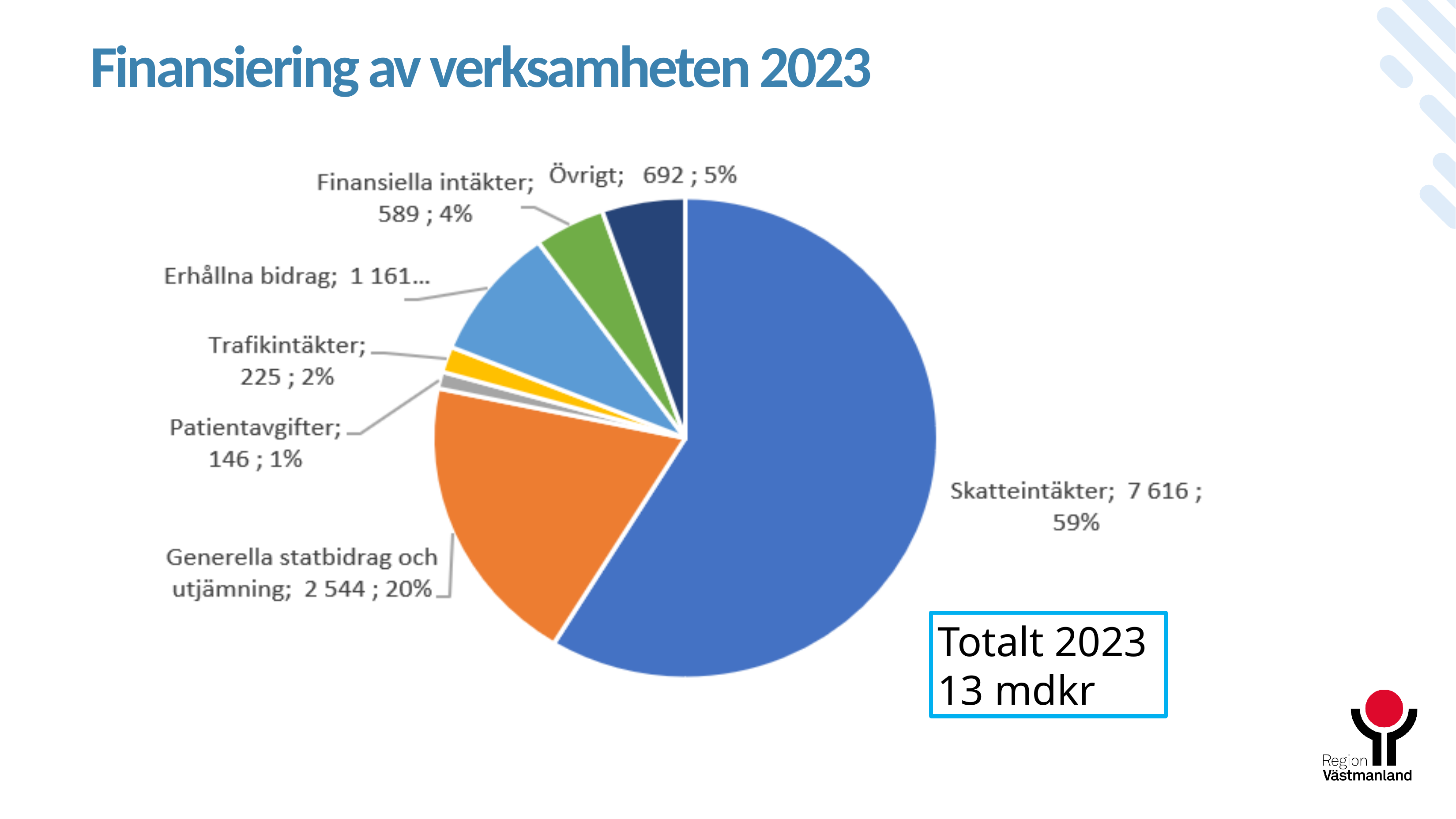
What is the value for Skatteintäkter? 7 616 What is the value for Generella statbidrag och utjämning? 2 544 What is the value for Patientavgifter? 146 Which category has the largest slice of the pie? Skatteintäkter What is the value for Erhållna bidrag? 1 161 How many slices does the pie chart have? 7 What kind of chart is shown on the slide? pie chart What share of the pie does Generella statbidrag och utjämning represent? 20% Which is larger, the value for Övrigt or the value for Finansiella intäkter? Övrigt What share of the pie does Övrigt represent? 5% Which category has the smallest slice of the pie? Patientavgifter What is the difference between the values for Skatteintäkter and Generella statbidrag och utjämning? 5 072